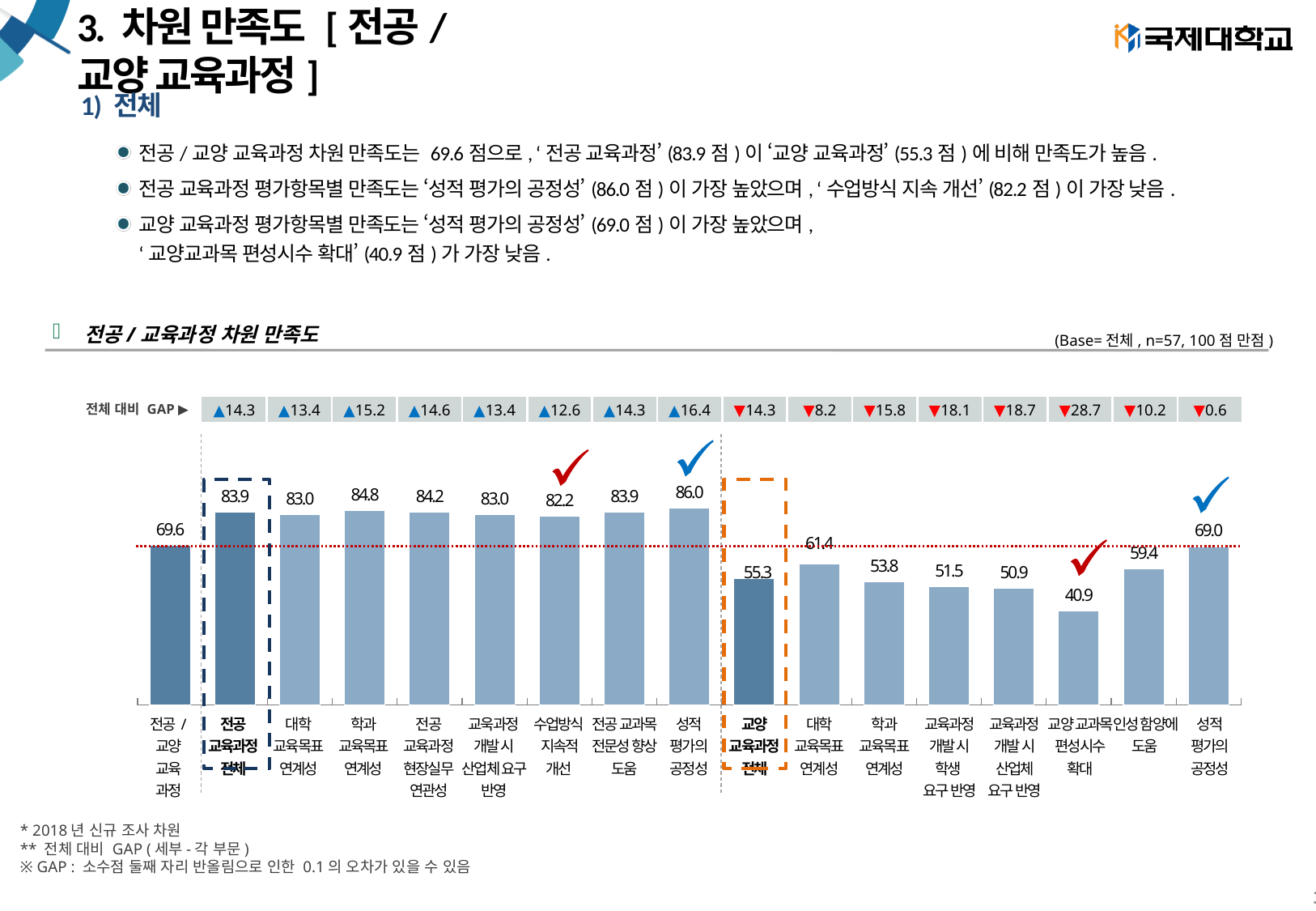
What is the value for '교양 교과목 편성시수 확대'? 40.9 What is the value for '전공 교육과정 전체'? 83.9 What is the value for '전공 / 교양 교육과정' overall, marked by the dotted horizontal line? 69.6 What is the 전체 대비 GAP shown above the '교양 교과목 편성시수 확대' bar? ▼28.7 What is the difference between '전공 교육과정 전체' (83.9) and '교양 교육과정 전체' (55.3)? 28.6 What is the value for '수업방식 지속적 개선' in the 전공 교육과정 section? 82.2 What is the value for '교양 교육과정 전체'? 55.3 What kind of chart is shown on the slide? Bar chart Which category has the lowest value on the chart? 교양 교과목 편성시수 확대 Which is larger: '인성 함양에 도움' or '대학 교육목표 연계성' in the 교양 교육과정 section? 대학 교육목표 연계성 Which category has the highest value on the chart? 성적 평가의 공정성 (전공 교육과정) How many bars are plotted on the chart? 17